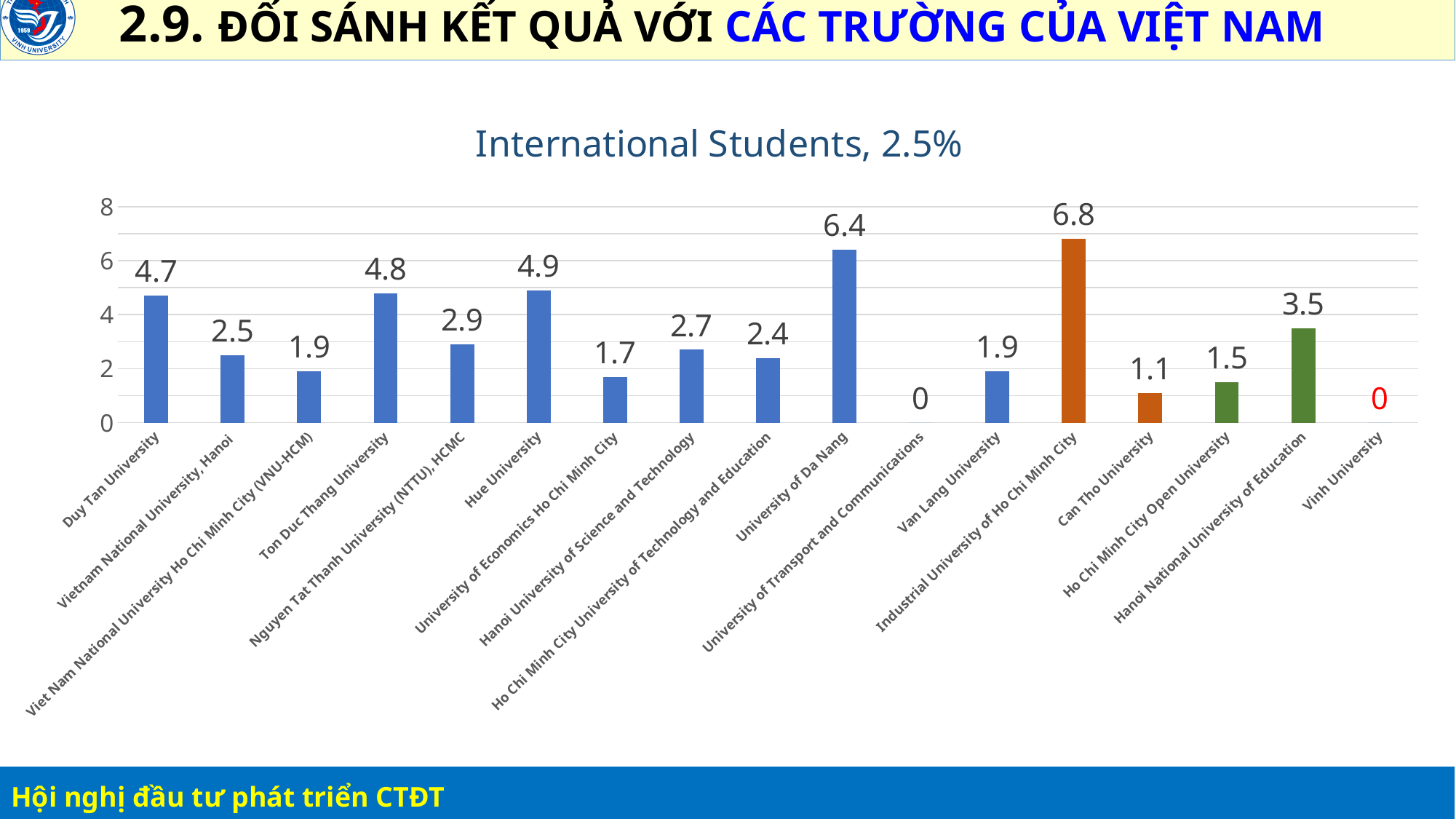
What is the value for Vinh University? 0 How many universities have a value of 0? 2 How many universities are shown on the x axis? 17 What is the value for Can Tho University? 1.1 Which is larger, the value for Hue University or the value for University of Economics Ho Chi Minh City? Hue University What kind of chart is shown? Bar chart What is the title of the chart? International Students, 2.5% What is the difference between Industrial University of Ho Chi Minh City and University of Da Nang? 0.4 Which university has the highest value? Industrial University of Ho Chi Minh City What is the value for Hanoi National University of Education? 3.5 What is the value for University of Da Nang? 6.4 What is the difference between Hanoi National University of Education and Ho Chi Minh City Open University? 2